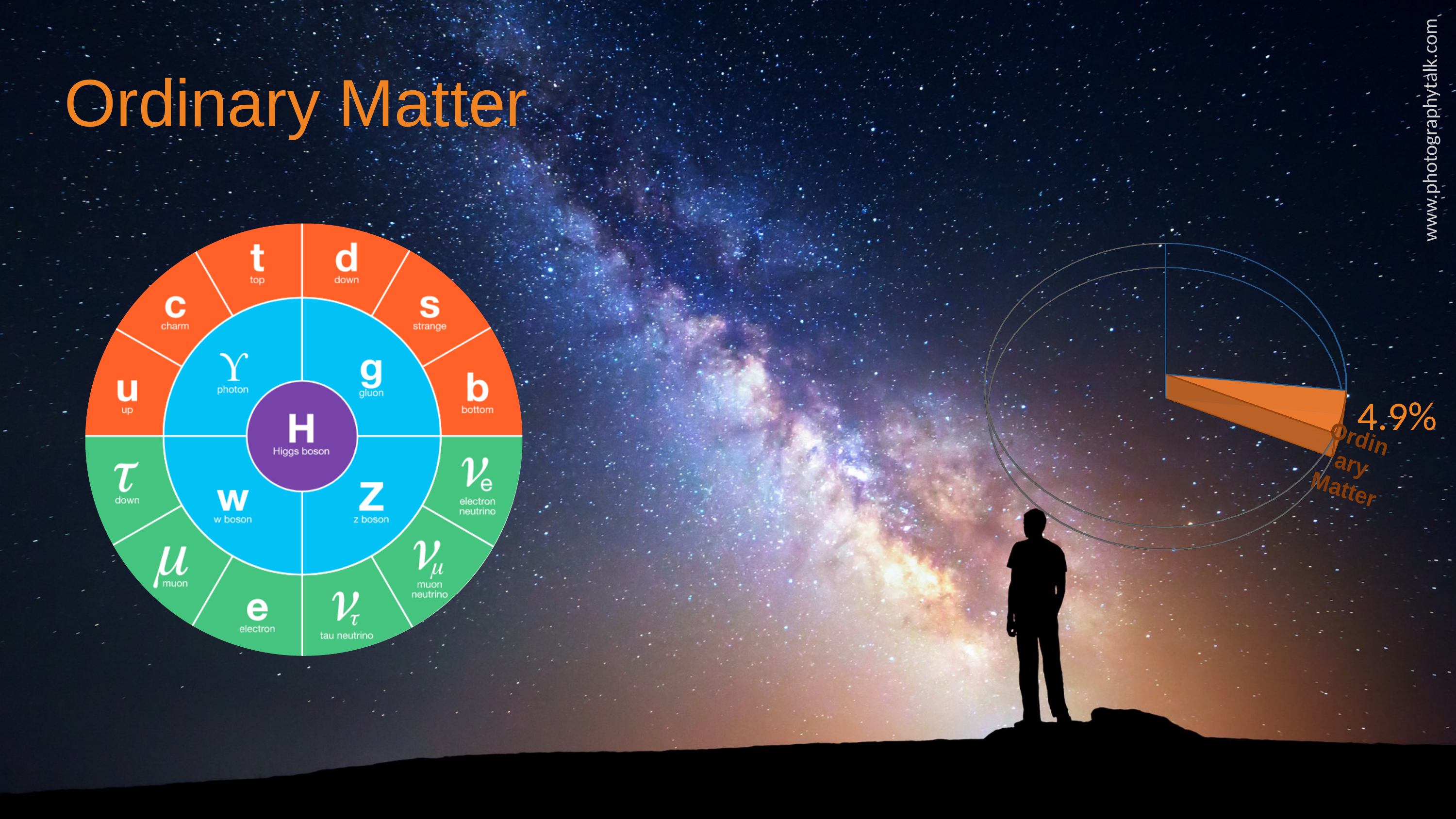
In the pie chart, what value is shown for the Ordinary Matter slice? 4.9% What is the label of the only visibly filled slice in the pie chart? Ordinary Matter What kind of chart is shown on the right side of the slide? pie chart What is the title of the slide containing the pie chart? Ordinary Matter What share of the pie chart does the Ordinary Matter slice represent? 4.9% What colour is the Ordinary Matter slice in the pie chart? orange